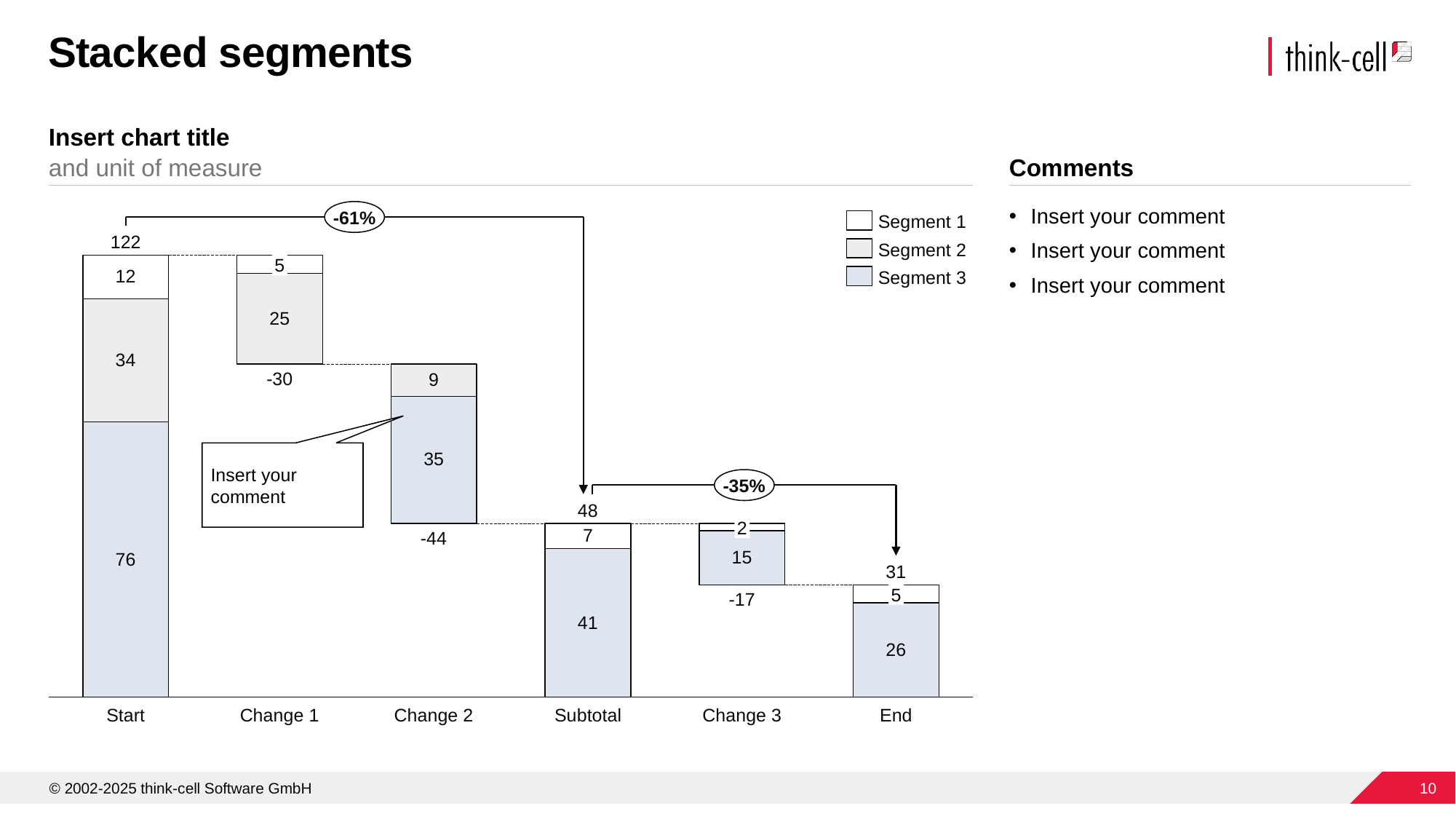
What is the change shown for Change 2? -44 What is the total value of the Subtotal bar? 48 How many categories are shown on the x axis? 6 What is the difference between the Start total and the End total? 91 What kind of chart is shown? waterfall chart What is the total value of the End bar? 31 How many series does the legend list? 3 What is the total value of the Start bar? 122 What is the value of Segment 3 in the Start bar? 76 What is the value of Segment 2 in the Change 1 bar? 25 What percentage change is shown between Subtotal and End? -35% What percentage change is shown between Start and Subtotal? -61%